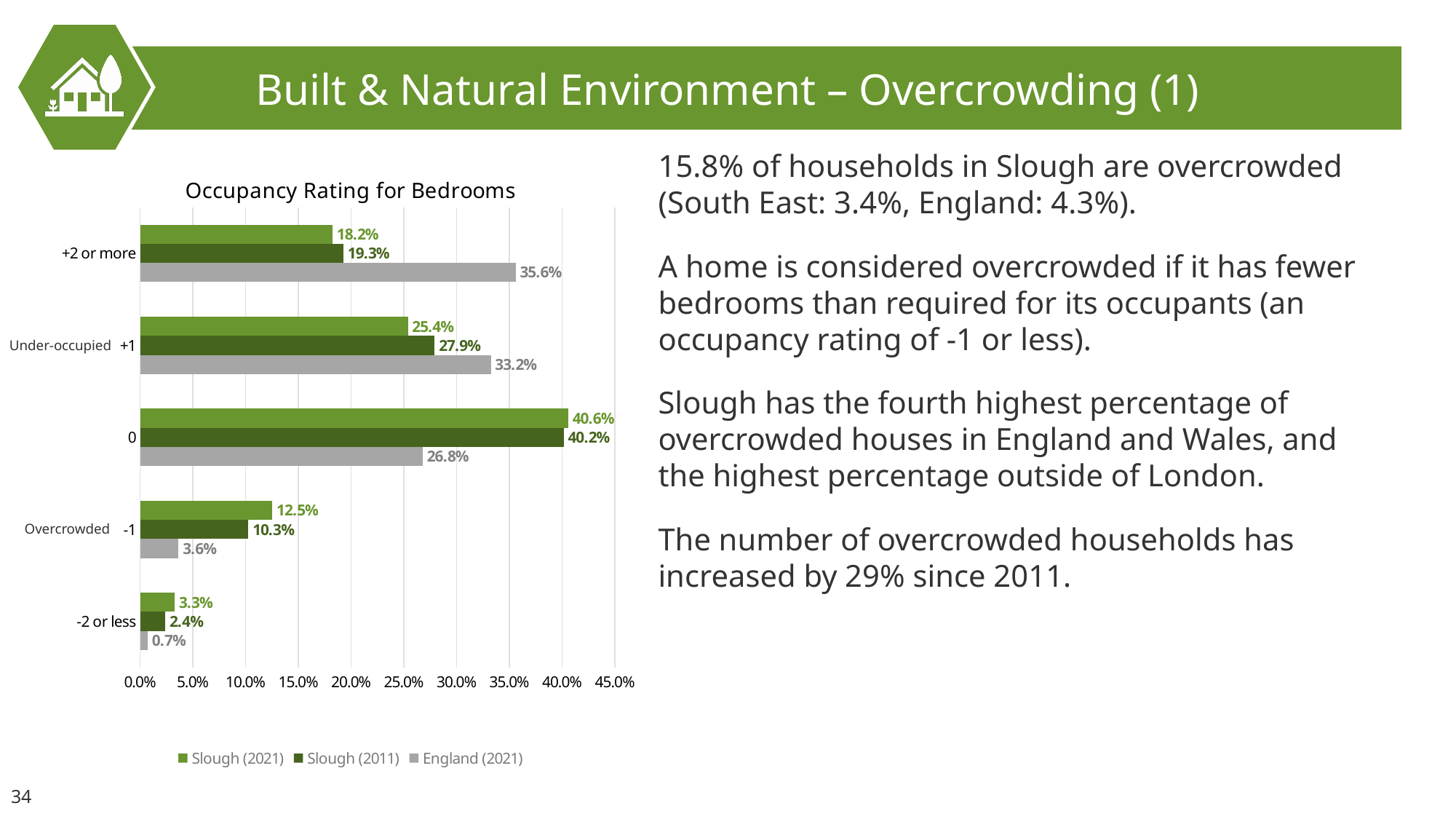
What is the difference between the Slough (2021) and England (2021) values in the '-1' category? 8.9% What is the title of the chart? Occupancy Rating for Bedrooms How many series does the legend list? 3 What kind of chart is shown on the slide? Bar chart How many occupancy rating categories are shown on the chart? 5 What is the value for England (2021) in the '+2 or more' category? 35.6% Which occupancy rating category has the lowest value for England (2021)? -2 or less Is the value for Slough (2021) in the '+1' category greater or less than 30.0%? less What is the value for Slough (2011) in the '-1' (Overcrowded) category? 10.3% Which is larger in the '+1' category: Slough (2011) or England (2021)? England (2021) Which occupancy rating category has the highest value for Slough (2021)? 0 What is the value for Slough (2021) in the '0' occupancy rating category? 40.6%